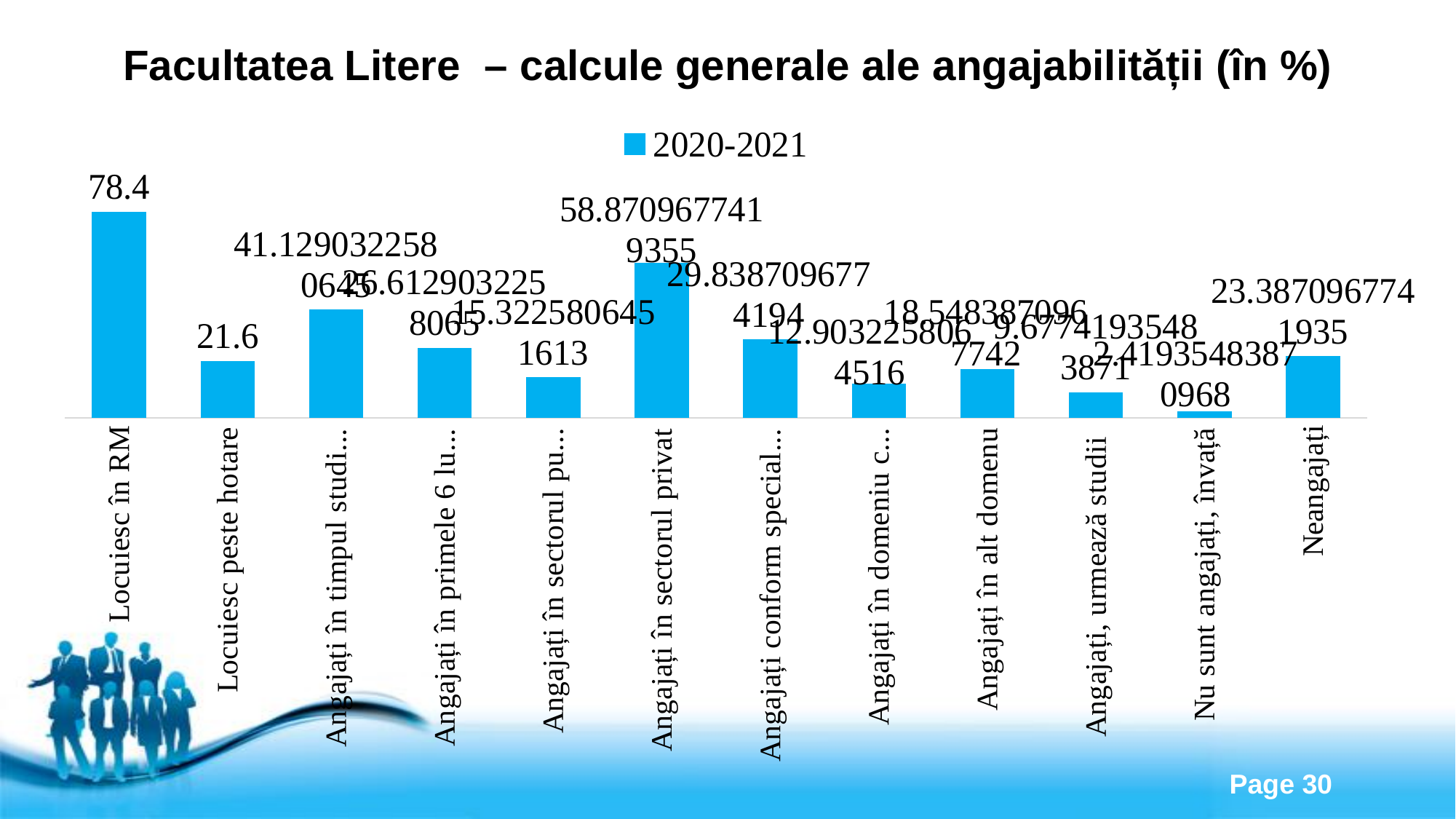
What series name is shown in the legend? 2020-2021 What is the value for Neangajați? 23.3870967741935 What is the value for Locuiesc în RM? 78.4 What is the value for Locuiesc peste hotare? 21.6 Which category has the lowest value? Nu sunt angajați, învață What is the value for Angajați în sectorul privat? 58.8709677419355 How many series does the legend list? 1 What is the difference between the values for Locuiesc în RM and Locuiesc peste hotare? 56.8 Which is larger, the value for Angajați în sectorul privat or the value for Neangajați? Angajați în sectorul privat Which category has the highest value? Locuiesc în RM How many categories are shown in the chart? 12 What kind of chart is shown on the slide? bar chart